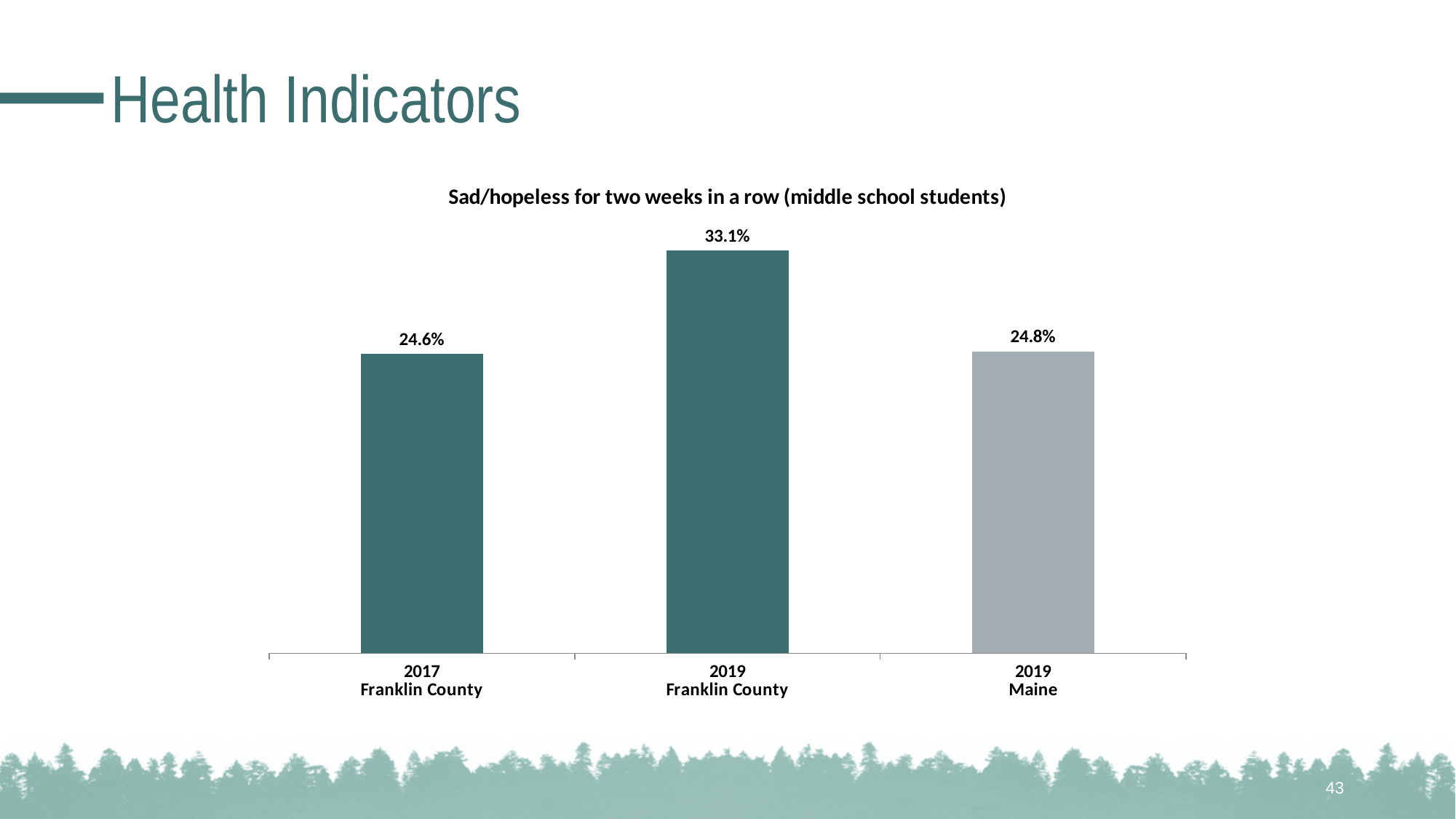
What is the title of the chart? Sad/hopeless for two weeks in a row (middle school students) How many bars are shown in the chart? 3 Which bar is shown in a different (grey) colour from the others? 2019 Maine Which category has the highest value? 2019 Franklin County What is the value for 2019 Franklin County? 33.1% What is the difference between the 2019 Franklin County value and the 2017 Franklin County value? 8.5% What is the difference between the 2019 Franklin County value and the 2019 Maine value? 8.3% Did the Franklin County value rise or fall from 2017 to 2019? Rise What is the value for 2019 Maine? 24.8% What is the value for 2017 Franklin County? 24.6% Which is larger, the value for 2019 Franklin County or the value for 2019 Maine? 2019 Franklin County What kind of chart is shown on the slide? Bar chart